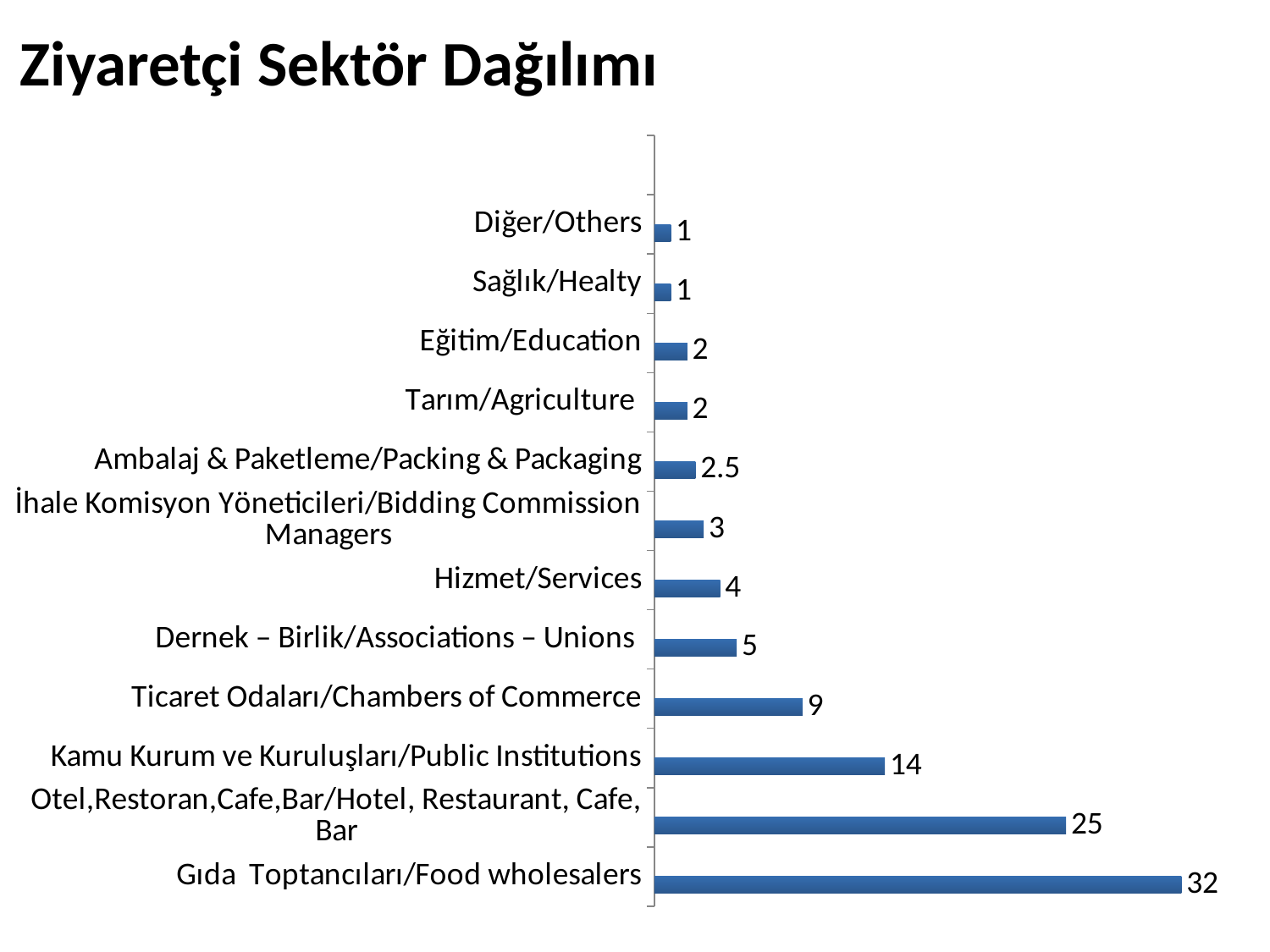
Which is larger, the value for Dernek – Birlik/Associations – Unions or the value for İhale Komisyon Yöneticileri/Bidding Commission Managers? Dernek – Birlik/Associations – Unions Which category has the highest value? Gıda Toptancıları/Food wholesalers What is the value for Hizmet/Services? 4 What is the value for Ambalaj & Paketleme/Packing & Packaging? 2.5 What is the value for Eğitim/Education? 2 What is the title of the slide? Ziyaretçi Sektör Dağılımı What is the difference between the values for Gıda Toptancıları/Food wholesalers and Otel,Restoran,Cafe,Bar/Hotel, Restaurant, Cafe, Bar? 7 How many categories are shown in the chart? 12 What kind of chart is shown on the slide? Bar chart What is the difference between the values for Otel,Restoran,Cafe,Bar/Hotel, Restaurant, Cafe, Bar and Ticaret Odaları/Chambers of Commerce? 16 What is the value for Kamu Kurum ve Kuruluşları/Public Institutions? 14 What is the value for Gıda Toptancıları/Food wholesalers? 32